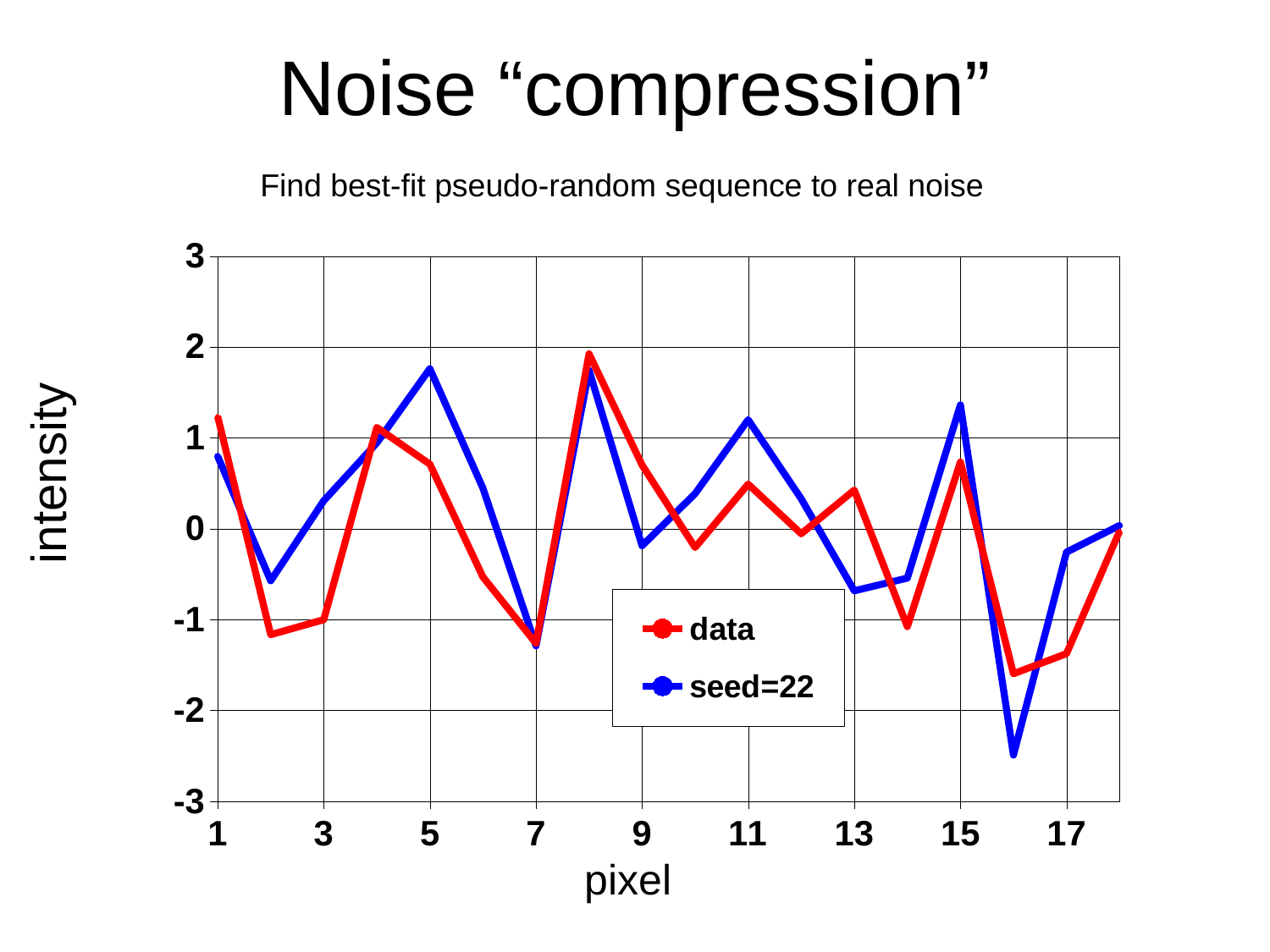
Is the value of the data series at pixel 2 greater or less than -1? less Is the value of the seed=22 series at pixel 16 greater or less than -2? less Is the value of the seed=22 series at pixel 5 greater or less than 1? greater What is the label on the vertical axis? intensity At pixel 11, which series has the higher value, data or seed=22? seed=22 How many series does the legend list? 2 At which pixel does the data series reach its highest value? 8 What kind of chart is shown on the slide? line chart At pixel 3, which series has the higher value, data or seed=22? seed=22 At which pixel does the seed=22 series reach its lowest value? 16 What are the two series named in the legend? data and seed=22